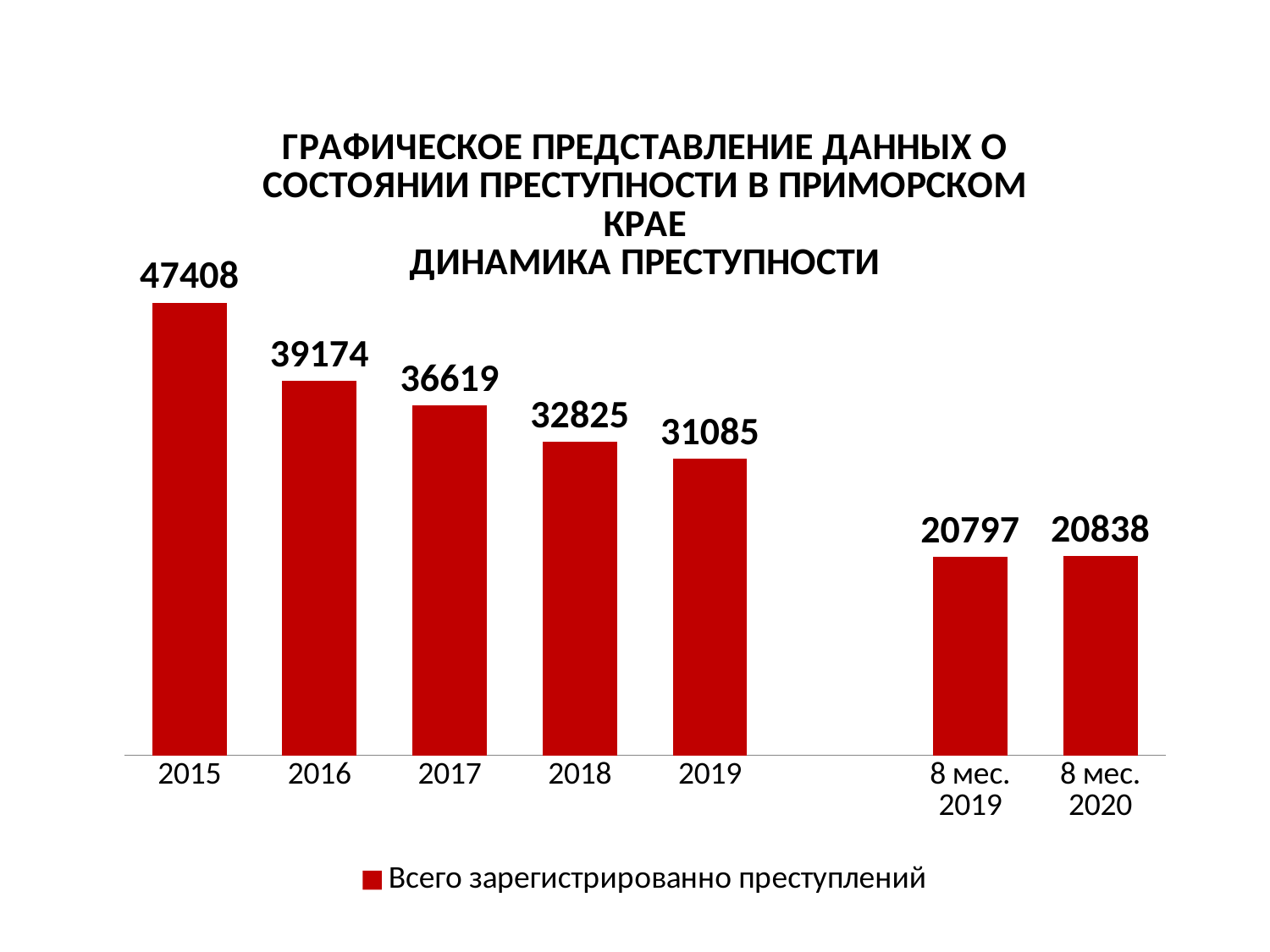
What is the difference between the values for 2015 and 2016? 8234 What is the difference between the values for 8 мес. 2020 and 8 мес. 2019? 41 Which category has the lowest value? 8 мес. 2019 What is the value for 2015? 47408 What kind of chart is shown on the slide? Bar chart Do the values rise or fall from 2015 to 2019? Fall How many bars are shown in the chart? 7 Which is larger, the value for 2017 or the value for 2019? 2017 Which category has the highest value? 2015 What is the value for 2018? 32825 What is the value for 8 мес. 2020? 20838 How many series does the legend list? 1